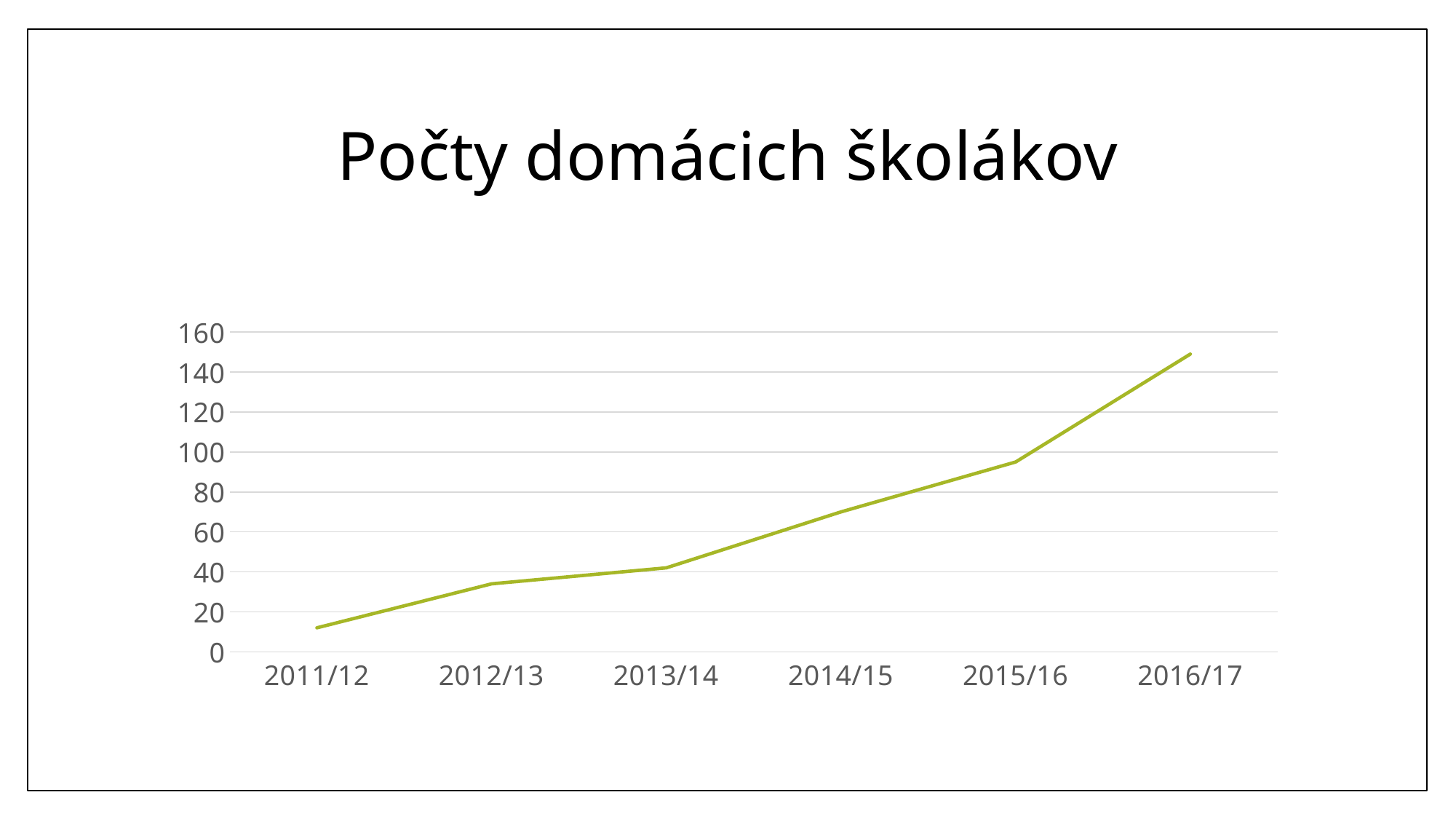
Which school year has the highest value? 2016/17 What colour is the plotted line? green What kind of chart is shown on the slide? line chart Is the value for 2012/13 greater or less than 20? greater What is the title of the chart? Počty domácich školákov Which school year has the lowest value? 2011/12 Do the values rise or fall from 2011/12 to 2016/17? rise Is the value for 2016/17 greater or less than 140? greater Is the value for 2014/15 greater or less than 60? greater Which is larger, the value for 2015/16 or the value for 2013/14? 2015/16 How many school years are plotted on the x axis? 6